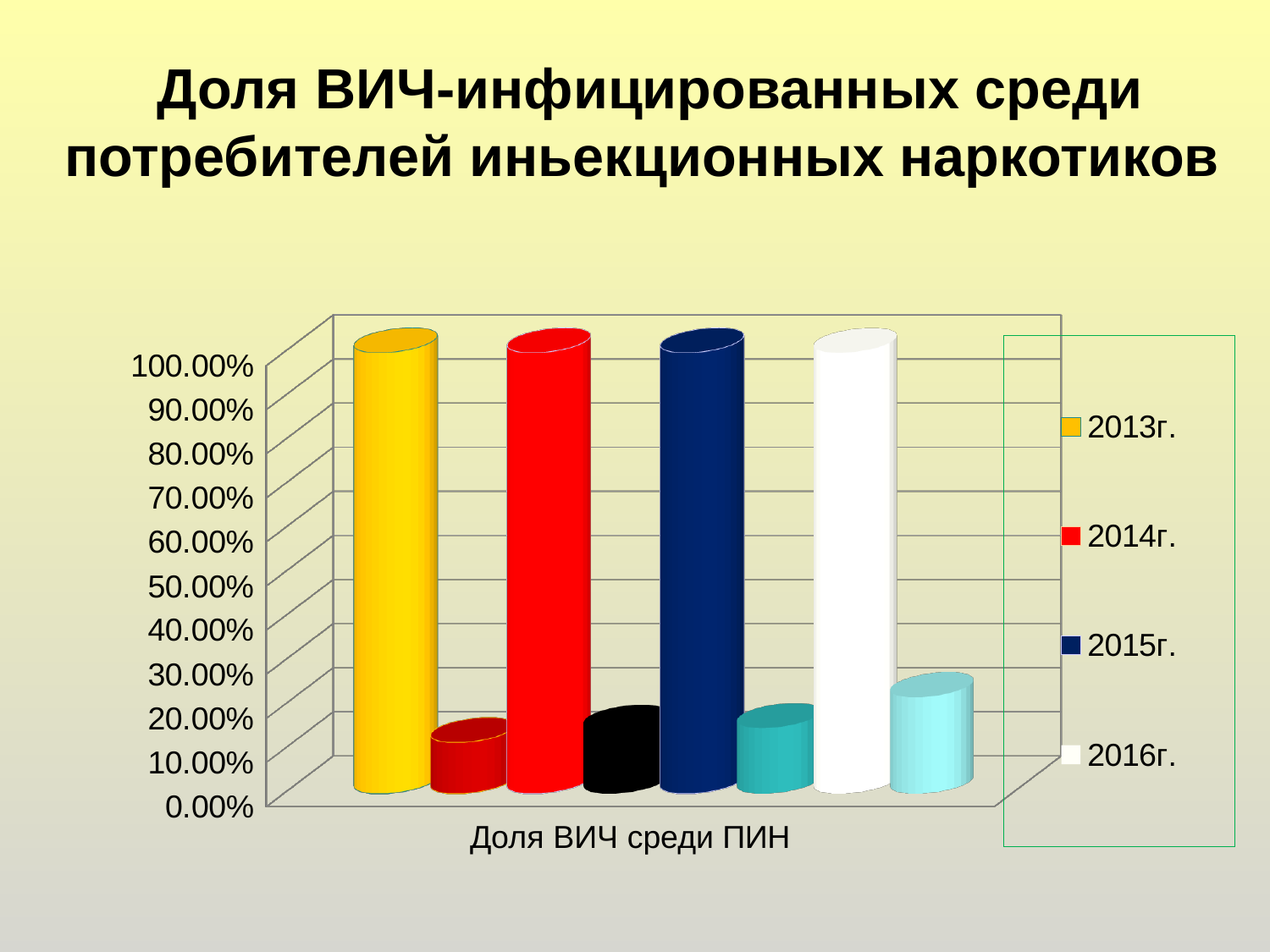
How many bars are plotted in the chart? 8 What kind of chart is shown on the slide? bar chart What is the highest value shown on the vertical axis? 100.00% What is the title of the slide's chart? Доля ВИЧ-инфицированных среди потребителей иньекционных наркотиков How many series does the legend list? 4 Is the value for 2013г. greater or less than 90.00%? greater Is the value for 2015г. greater or less than 80.00%? greater Is the value for 2014г. greater or less than 90.00%? greater What is the label shown on the category axis of the chart? Доля ВИЧ среди ПИН